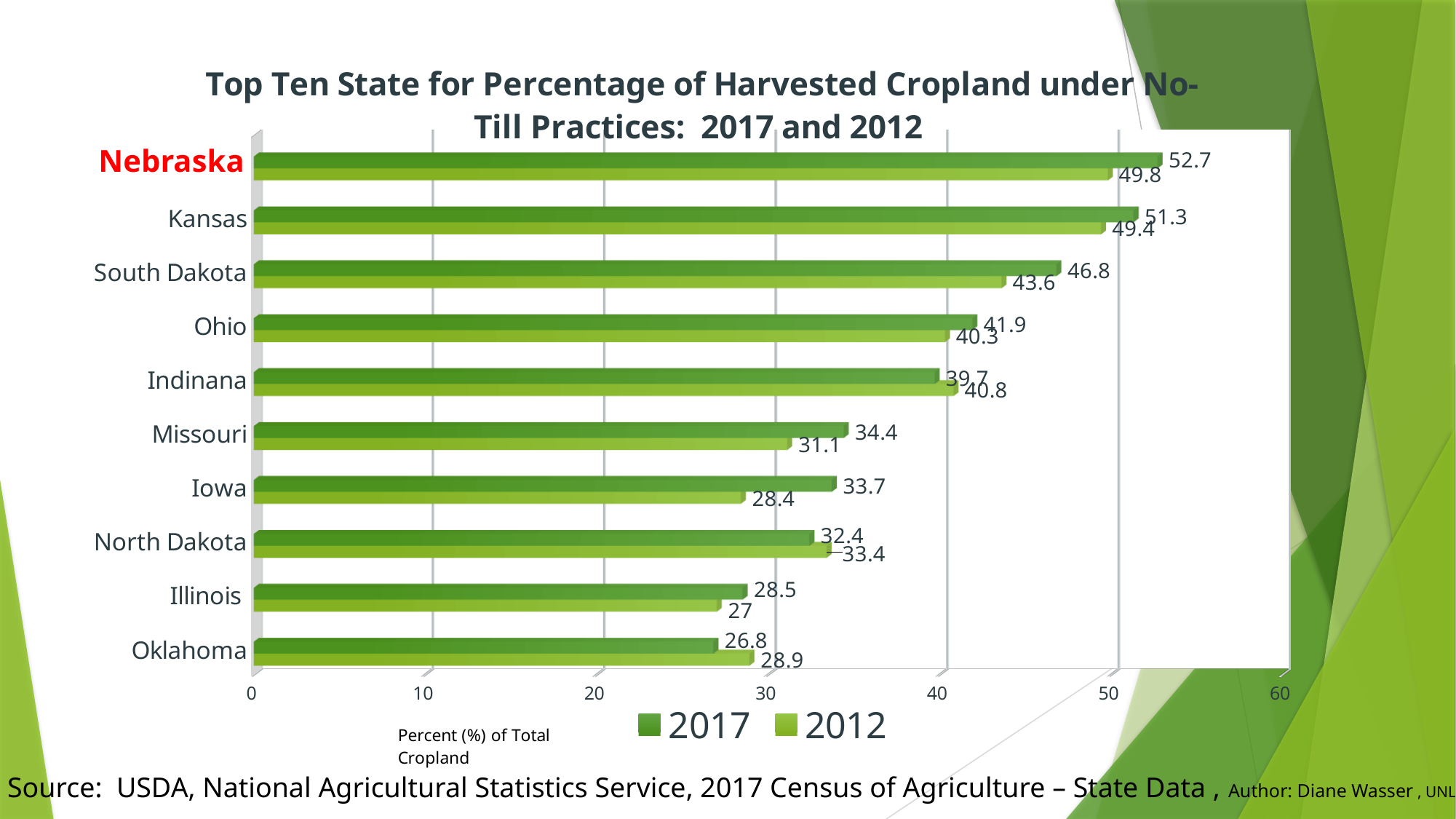
Is the 2017 value for South Dakota greater or less than 40? greater What is the difference between the 2017 and 2012 values for Iowa? 5.3 What kind of chart is shown on the slide? bar chart How many series does the legend list? 2 What is the label on the horizontal axis? Percent (%) of Total Cropland Which state has the highest 2017 value? Nebraska How many states are shown on the chart? 10 What is the 2012 value for Kansas? 49.4 What is the 2017 value for Oklahoma? 26.8 What is the 2017 value for Nebraska? 52.7 Which is larger for Indiana, the 2017 value or the 2012 value? 2012 Which state has the lowest 2012 value? Illinois